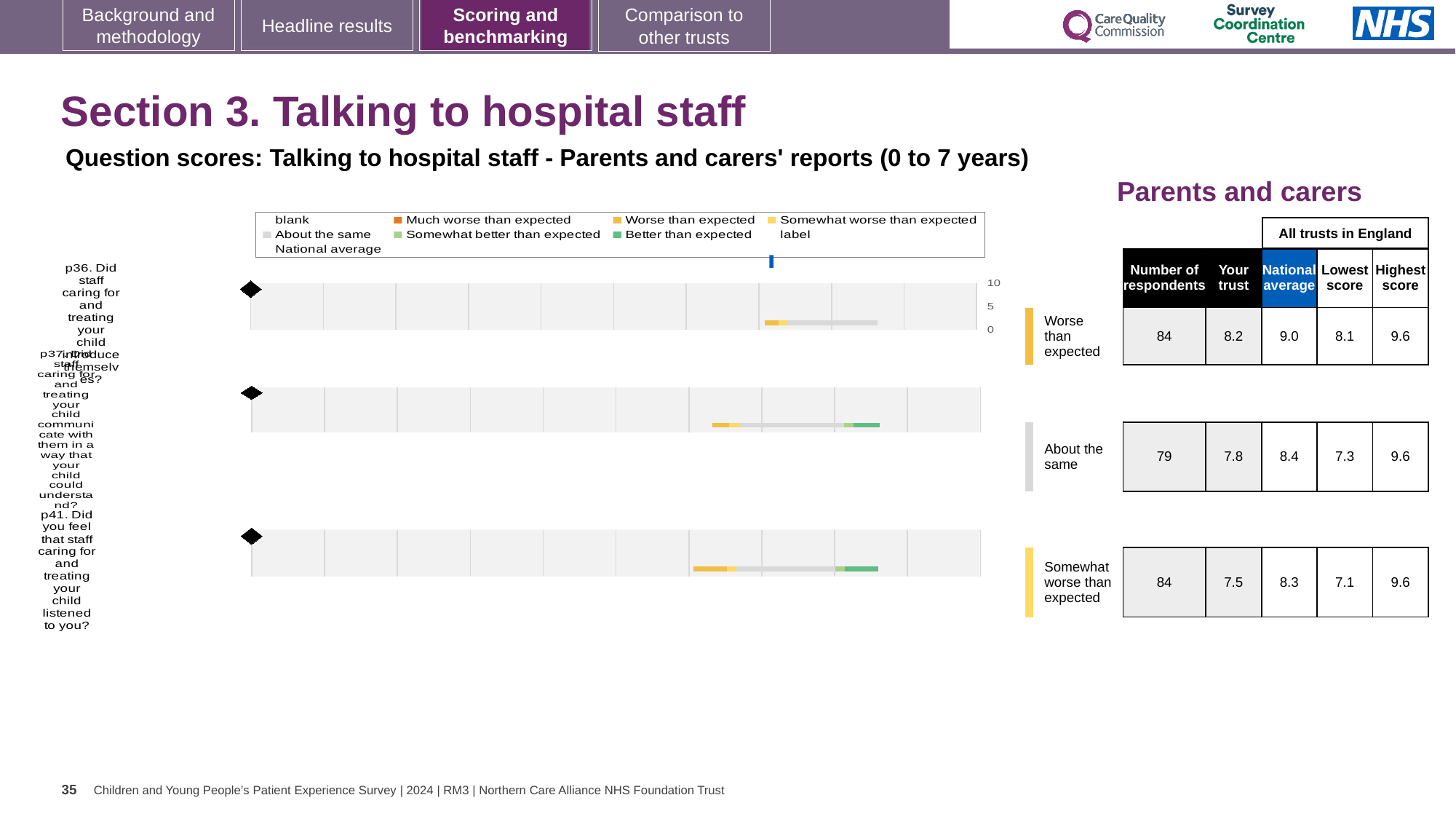
For p36, how much higher is the national average than the trust's score? 0.8 What kind of chart is used to show the question scores for Talking to hospital staff? bar chart How many respondents answered p37? 79 What is the lowest score among all trusts in England for p41 (Did you feel that staff caring for and treating your child listened to you)? 7.1 Which question has the highest 'Your trust' score? p36 What benchmark category is shown for p37? About the same What is the highest score among all trusts in England for p36? 9.6 Which question has the lowest 'Your trust' score? p41 How many survey questions (rows) are plotted in the chart? 3 What is the 'Your trust' score for p36 (Did staff caring for and treating your child introduce themselves)? 8.2 What is the national average score for p37 (Did staff communicate with them in a way that your child could understand)? 8.4 Which has the larger 'Your trust' score, p37 or p41? p37